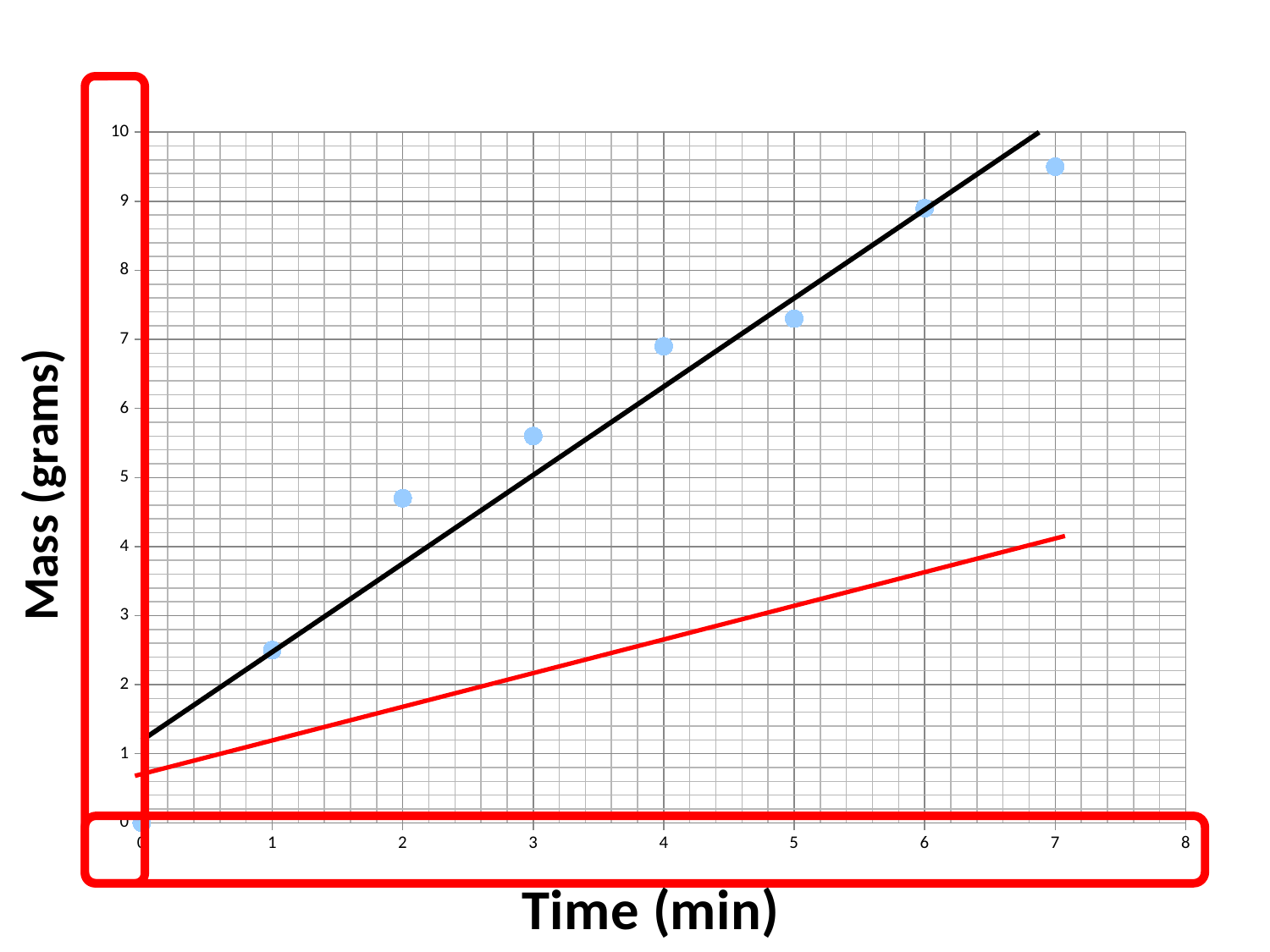
Which has the larger plotted mass, time 3 min or time 5 min? 5 min What is the title of the vertical axis? Mass (grams) Is the mass value at time 7 min greater or less than 9? greater What is the title of the horizontal axis? Time (min) At which time (min) is the plotted mass lowest? 0 At which time (min) is the plotted mass highest? 7 What kind of chart is shown on the slide? scatter chart Do the plotted mass values rise or fall as time increases? rise Is the mass value at time 4 min greater or less than 6? greater How many data points are plotted on the chart? 8 Is the mass value at time 2 min greater or less than 5? less